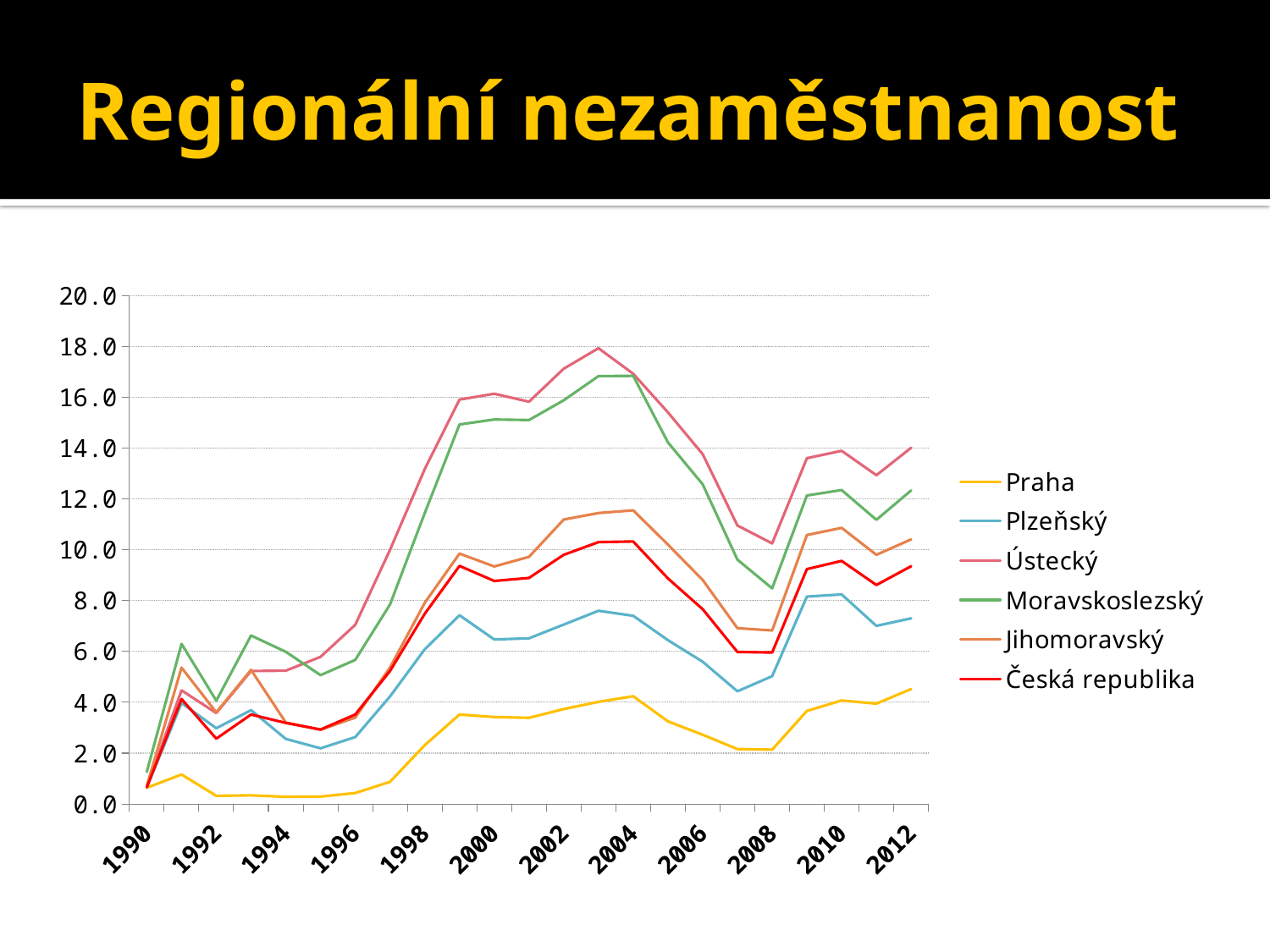
What kind of chart is shown on the slide? line chart Which series has the lowest values across the whole period? Praha What is the highest value shown on the y axis? 20.0 In 2012, which is larger: the value for Moravskoslezský or for Jihomoravský? Moravskoslezský Is the value for Plzeňský in 2010 greater or less than 6.0? greater Does the Praha line rise or fall between 2004 and 2008? fall Is the value for Praha in 2004 greater or less than 6.0? less Is the value for Česká republika in 2008 greater or less than 8.0? less Does the Ústecký line rise or fall between 1996 and 1999? rise How many series does the legend list? 6 Which series reaches the highest value anywhere on the chart? Ústecký